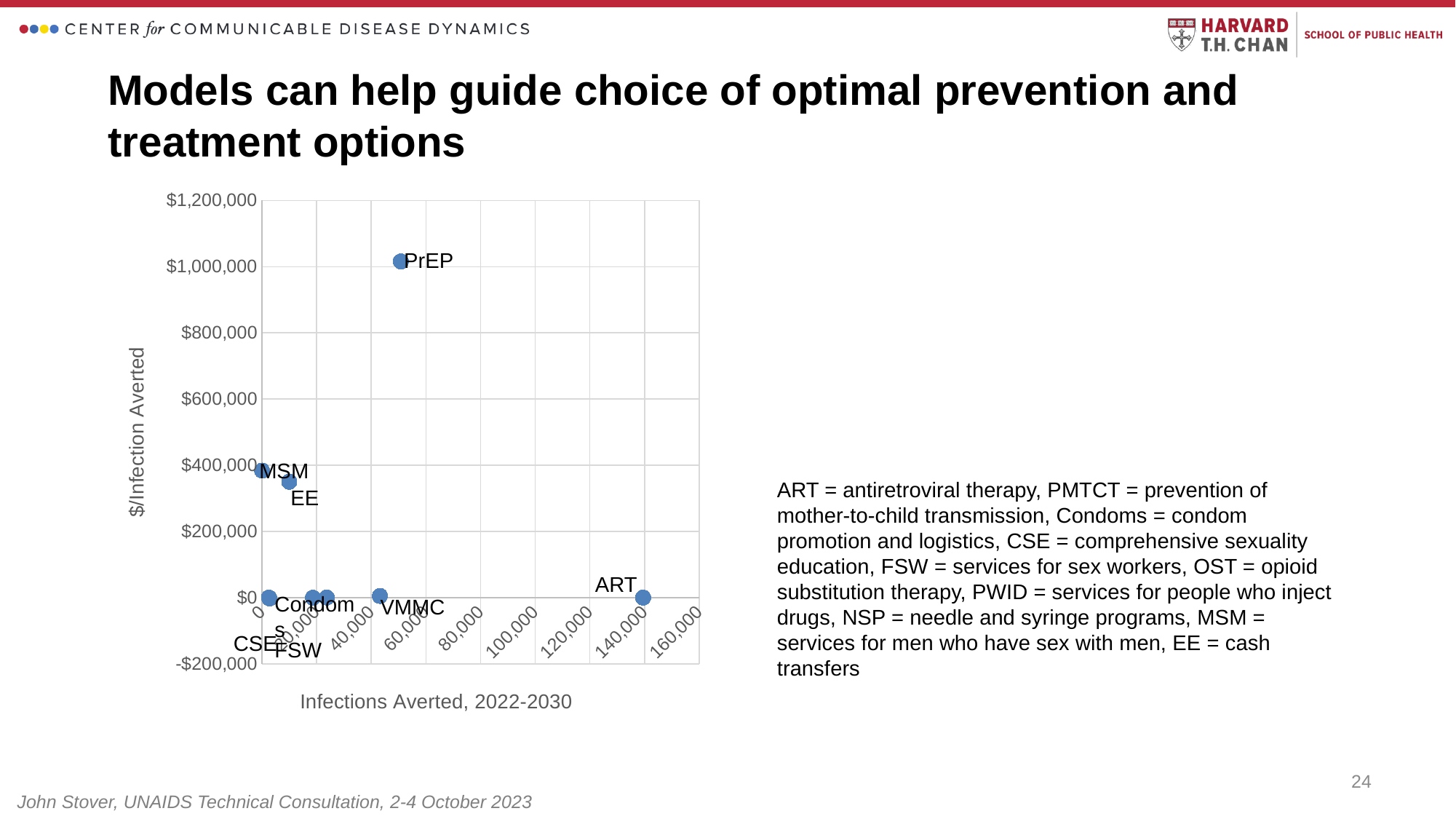
Which intervention averts the most infections over 2022-2030? ART Which has a higher cost per infection averted, MSM or EE? MSM Which has a higher cost per infection averted, PrEP or VMMC? PrEP Which intervention has the highest cost per infection averted? PrEP Is the cost per infection averted for MSM greater or less than $600,000? less What kind of chart is shown on the slide? scatter chart What is the title of the x axis? Infections Averted, 2022-2030 Is the number of infections averted by VMMC greater or less than 60,000? less What is the title of the y axis? $/Infection Averted Is the cost per infection averted for PrEP greater or less than $800,000? greater How many interventions are plotted on the chart? 8